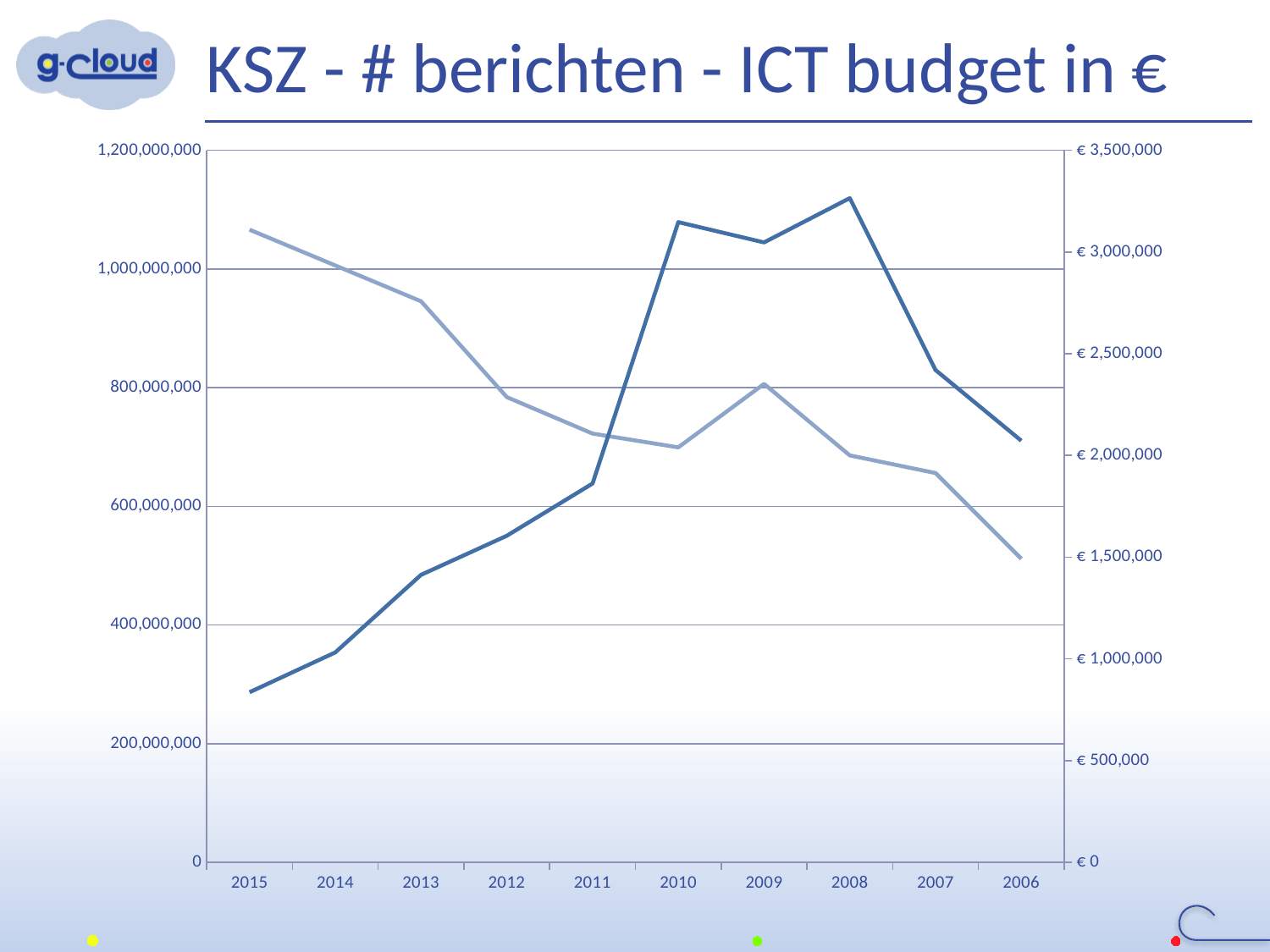
In which year is the lighter line at its lowest point? 2006 What is the highest tick value shown on the right-hand axis? € 3,500,000 How many lines are plotted on the chart? 2 What kind of chart is shown on the slide? line chart How many years are shown on the x axis of the chart? 10 In which year is the lighter line at its highest point? 2015 What is the title of the chart slide? KSZ - # berichten - ICT budget in € In which year is the darker line at its lowest point? 2015 Is the darker line higher in 2010 or in 2011? 2010 In which year does the darker line reach its highest point? 2008 Does the lighter line generally rise or fall from 2015 to 2012 along the x axis? fall Is the lighter line higher in 2009 or in 2010? 2009